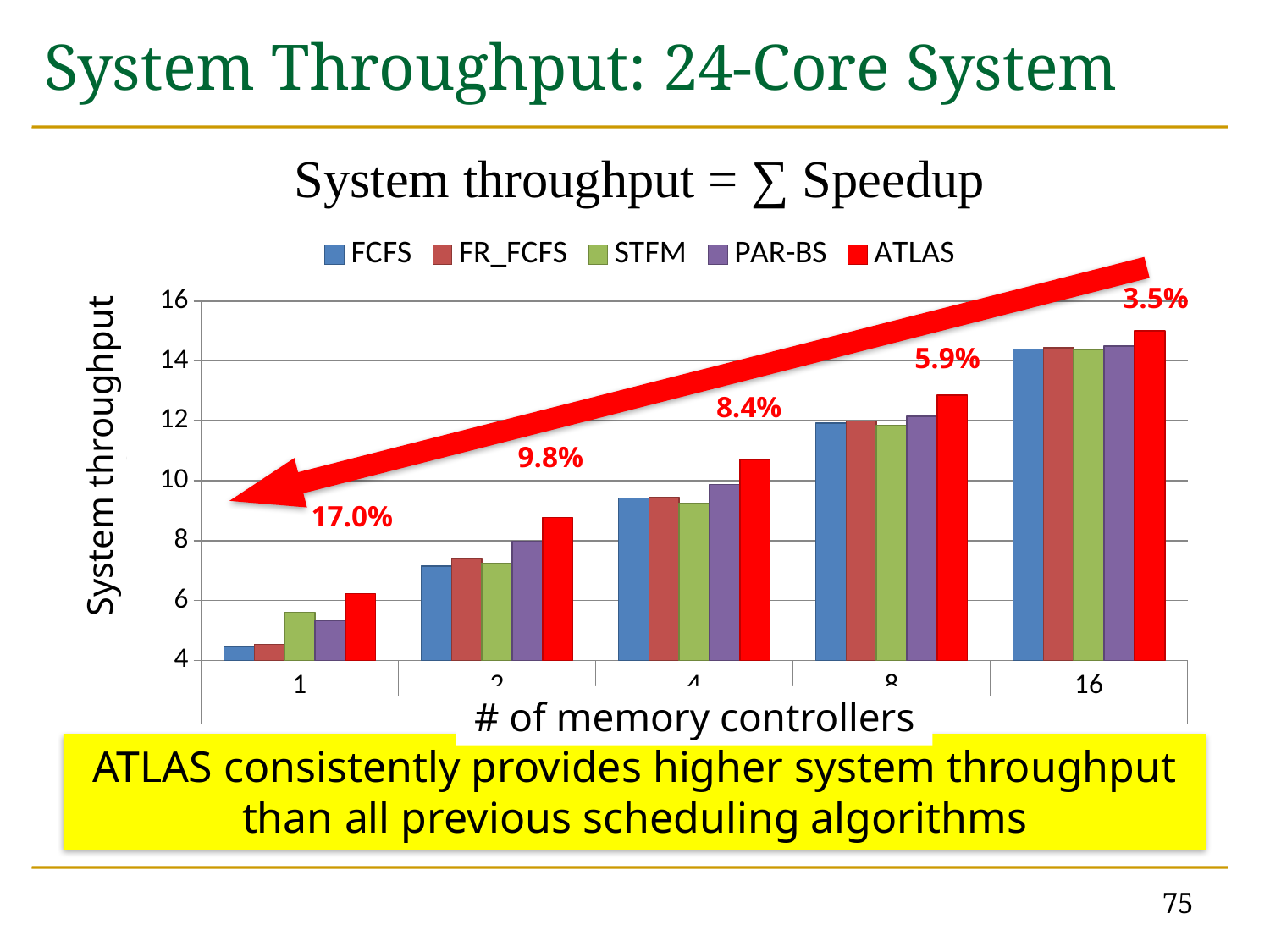
Which series has the highest system throughput at 1 memory controller? ATLAS Does system throughput rise or fall as the number of memory controllers increases? rises How many memory-controller categories are shown on the x axis? 5 How many series does the legend list? 5 Is the FCFS value at 1 memory controller greater or less than 6? less Which series has the highest system throughput at 16 memory controllers? ATLAS Is the ATLAS value at 2 memory controllers greater or less than 8? greater What kind of chart is shown on the slide? bar chart Is the ATLAS value at 8 memory controllers greater or less than 12? greater What percentage improvement is annotated above the 1 memory controller group? 17.0% At 1 memory controller, which is larger: the STFM value or the FCFS value? STFM